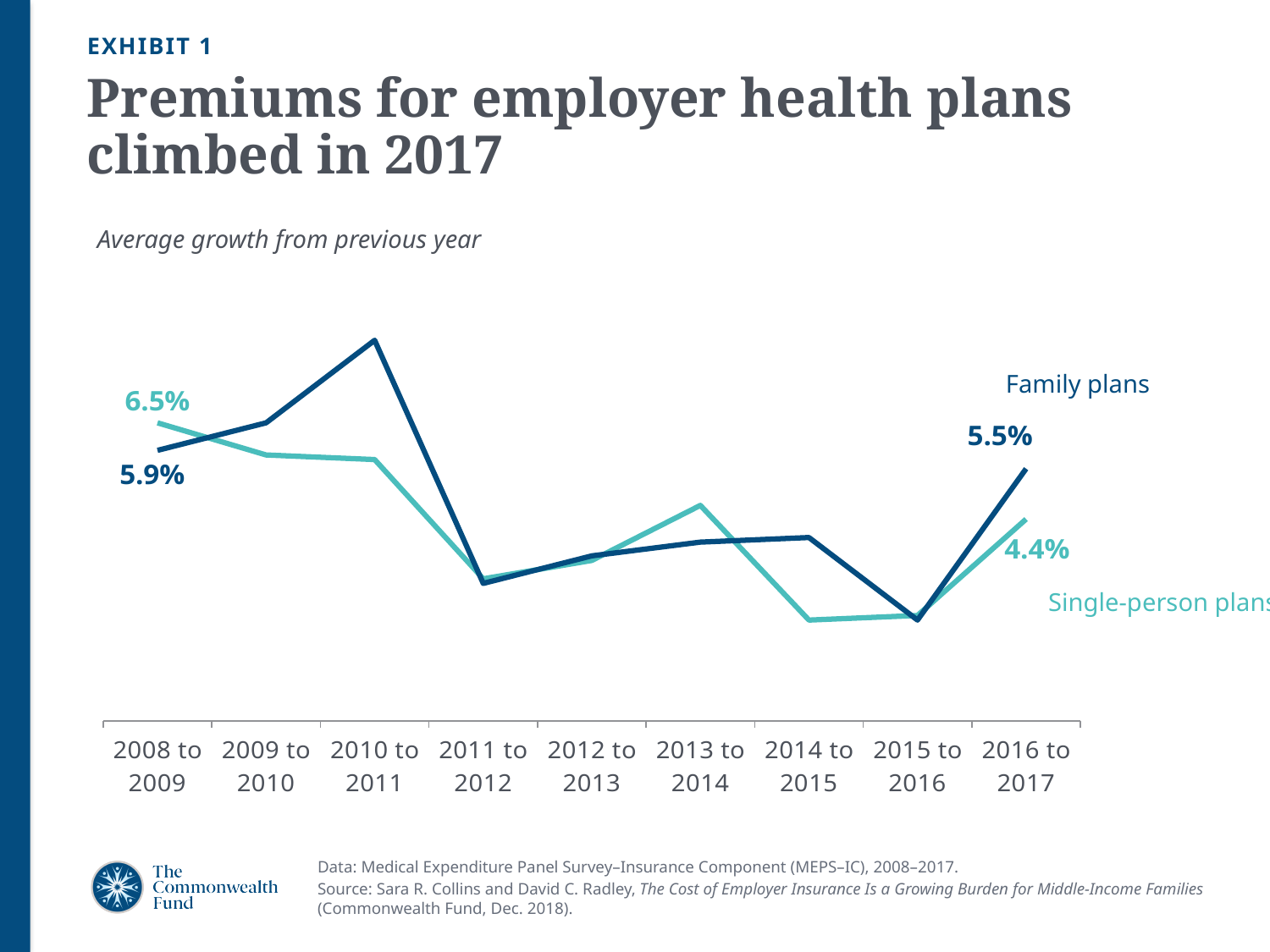
By how many percentage points did single-person plan growth exceed family plan growth from 2008 to 2009? 0.6 percentage points How many year-to-year periods are shown on the x axis? 9 What was the average growth for family plans from 2016 to 2017? 5.5% What type of chart is shown on the slide? Line chart Which series had higher growth from 2008 to 2009, family plans or single-person plans? Single-person plans In which period did family plans reach their highest growth? 2010 to 2011 Which series had higher growth from 2016 to 2017, family plans or single-person plans? Family plans What was the average growth for single-person plans from 2016 to 2017? 4.4% By how many percentage points did family plan growth exceed single-person plan growth from 2016 to 2017? 1.1 percentage points How many series are plotted on the chart? 2 What was the average growth for single-person plans from 2008 to 2009? 6.5% What was the average growth for family plans from 2008 to 2009? 5.9%